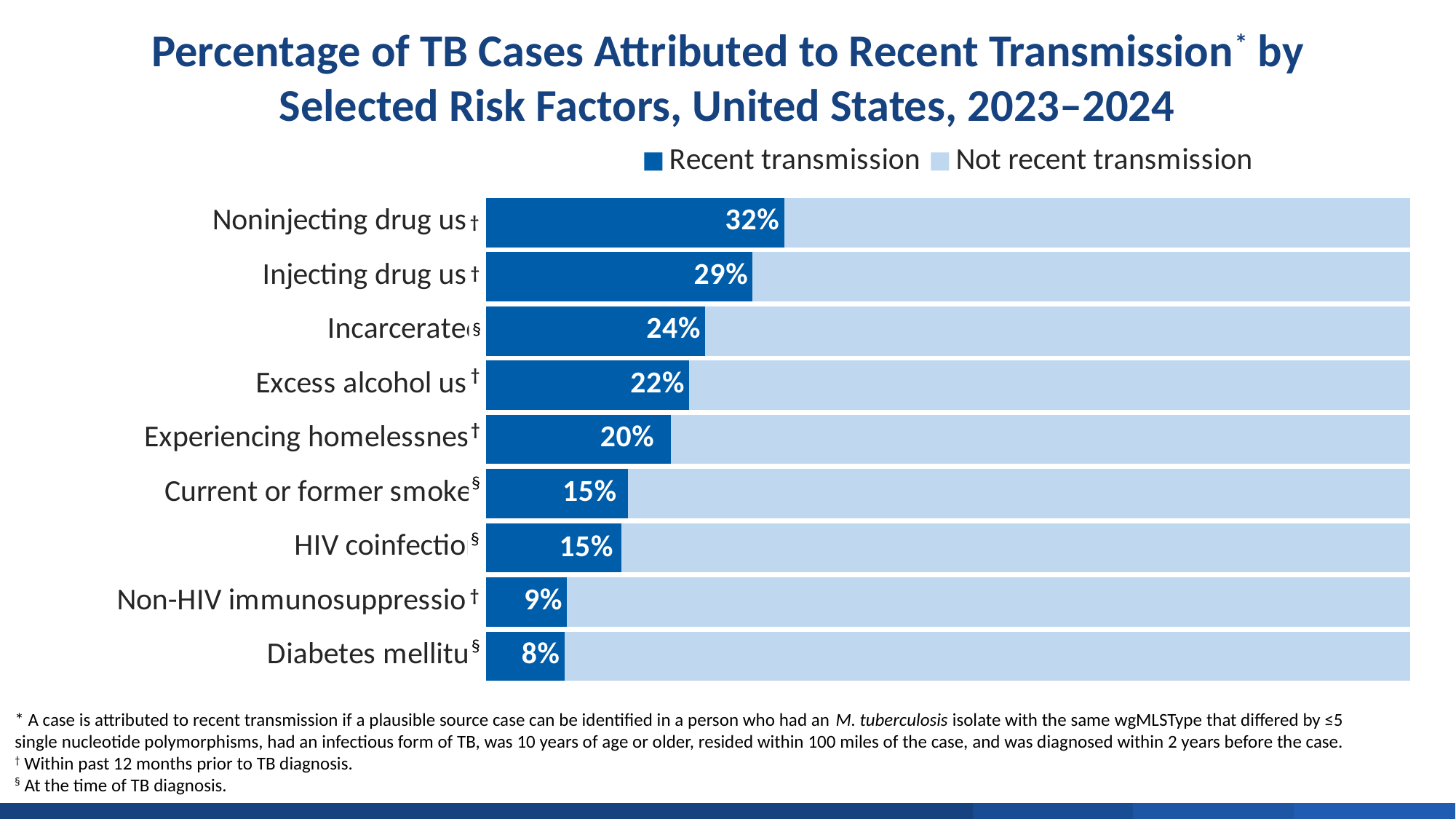
What percentage of TB cases among people with noninjecting drug use is attributed to recent transmission? 32% How many risk factor categories are shown in the chart? 9 Which series is shown in dark blue according to the legend? Recent transmission Which has a higher percentage of TB cases attributed to recent transmission: HIV coinfection or non-HIV immunosuppression? HIV coinfection What kind of chart is shown on the slide? Stacked bar chart What percentage of TB cases among people with diabetes mellitus is attributed to recent transmission? 8% What percentage of TB cases among people who were incarcerated is attributed to recent transmission? 24% How many series does the legend list? 2 Which risk factor has the highest percentage of TB cases attributed to recent transmission? Noninjecting drug use What is the difference in percentage points between the recent transmission values for injecting drug use and excess alcohol use? 7 What percentage of TB cases among people experiencing homelessness is attributed to recent transmission? 20% Which risk factor has the lowest percentage of TB cases attributed to recent transmission? Diabetes mellitus